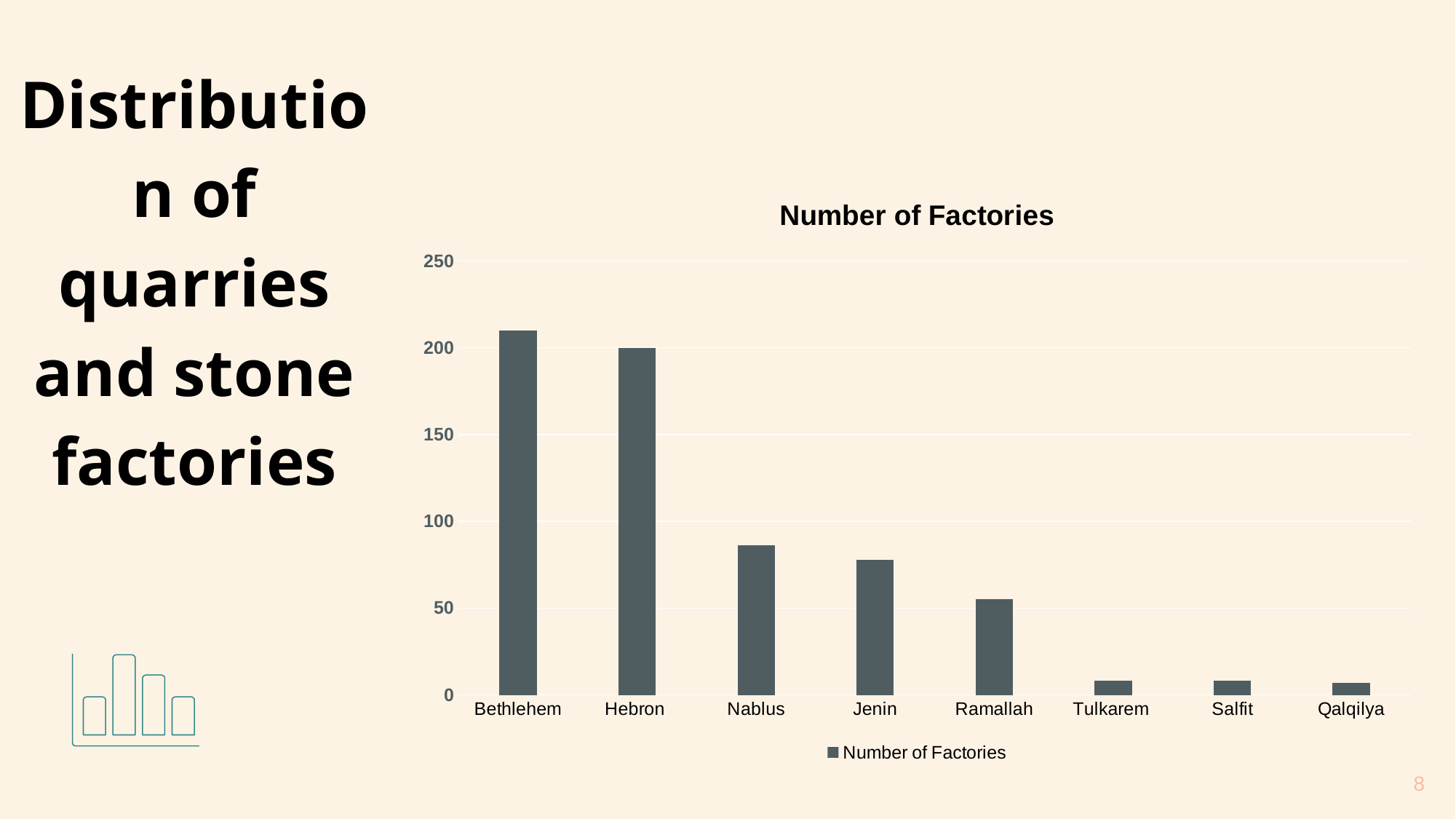
What is the title of the chart? Number of Factories Do the values rise or fall moving from left to right along the x axis? fall Which has more factories, Jenin or Ramallah? Jenin Is the value for Bethlehem greater or less than 200? greater How many categories are shown on the x axis of the chart? 8 Is the value for Nablus greater or less than 100? less Is the value for Jenin greater or less than 50? greater How many series does the legend list? 1 What kind of chart is shown on the slide? bar chart Which category has the highest number of factories? Bethlehem Which has more factories, Bethlehem or Hebron? Bethlehem